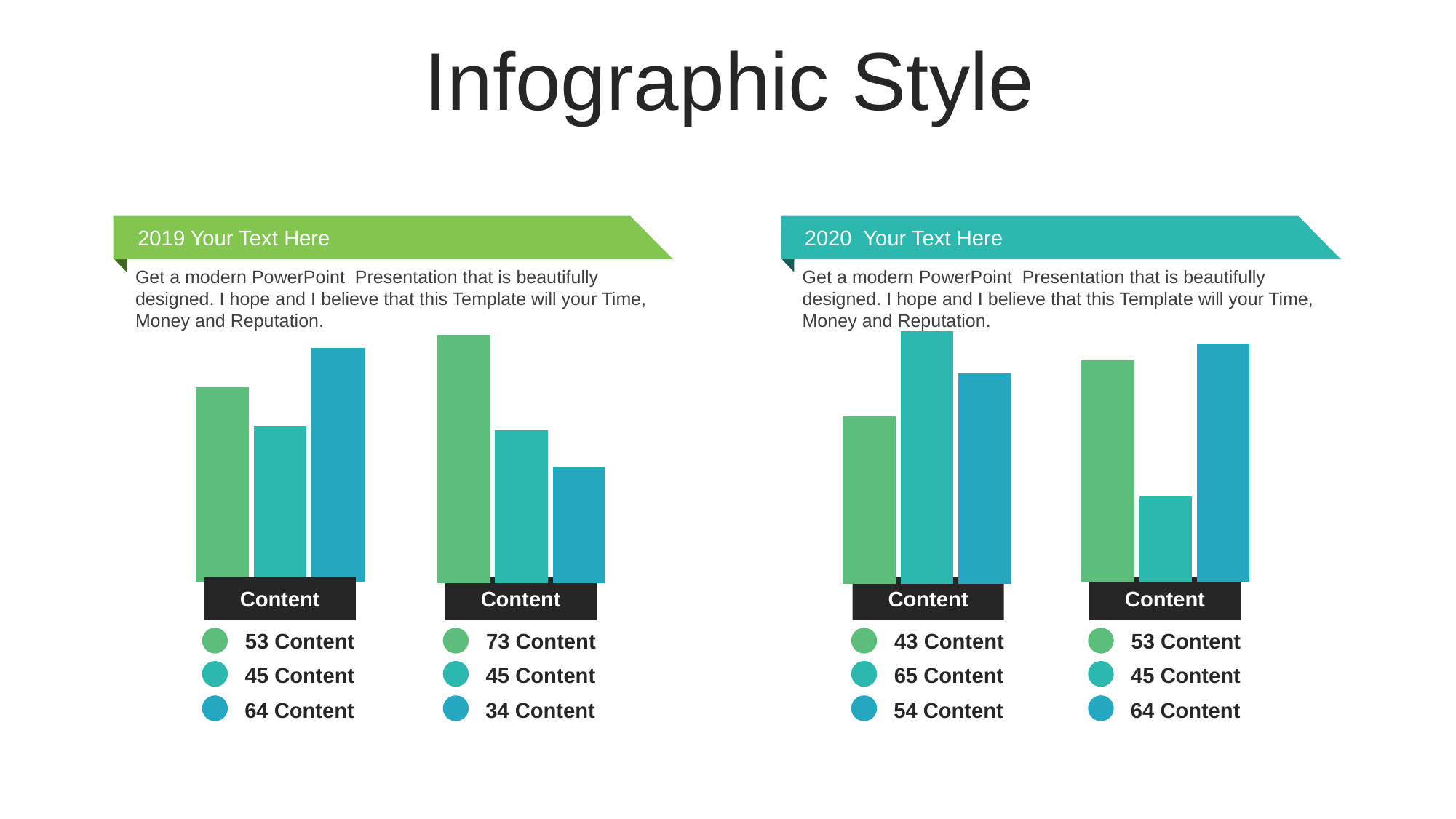
In the second bar group under the 2019 heading, which bar is the lowest? the dark blue bar (34) In the leftmost bar group under the 2020 heading, what value is listed for the light green bar? 43 In the second bar group under the 2019 heading, what is the difference between the light green bar and the dark blue bar? 39 In the leftmost bar group under the 2019 heading, which is larger, the light green bar or the dark blue bar? the dark blue bar In the second bar group under the 2019 heading, do the bar values rise or fall from left to right? fall In the leftmost bar group under the 2019 heading, what value is listed for the dark blue bar? 64 In the leftmost bar group under the 2020 heading, which bar is the highest? the teal bar (65) In the leftmost bar group under the 2019 heading, what value is listed for the light green bar? 53 What kind of chart is used in each group on the slide? bar chart How many bars are in each bar group on the slide? 3 In the second bar group under the 2019 heading, what value is listed for the light green bar? 73 In the rightmost bar group under the 2020 heading, what is the difference between the dark blue bar and the teal bar? 19